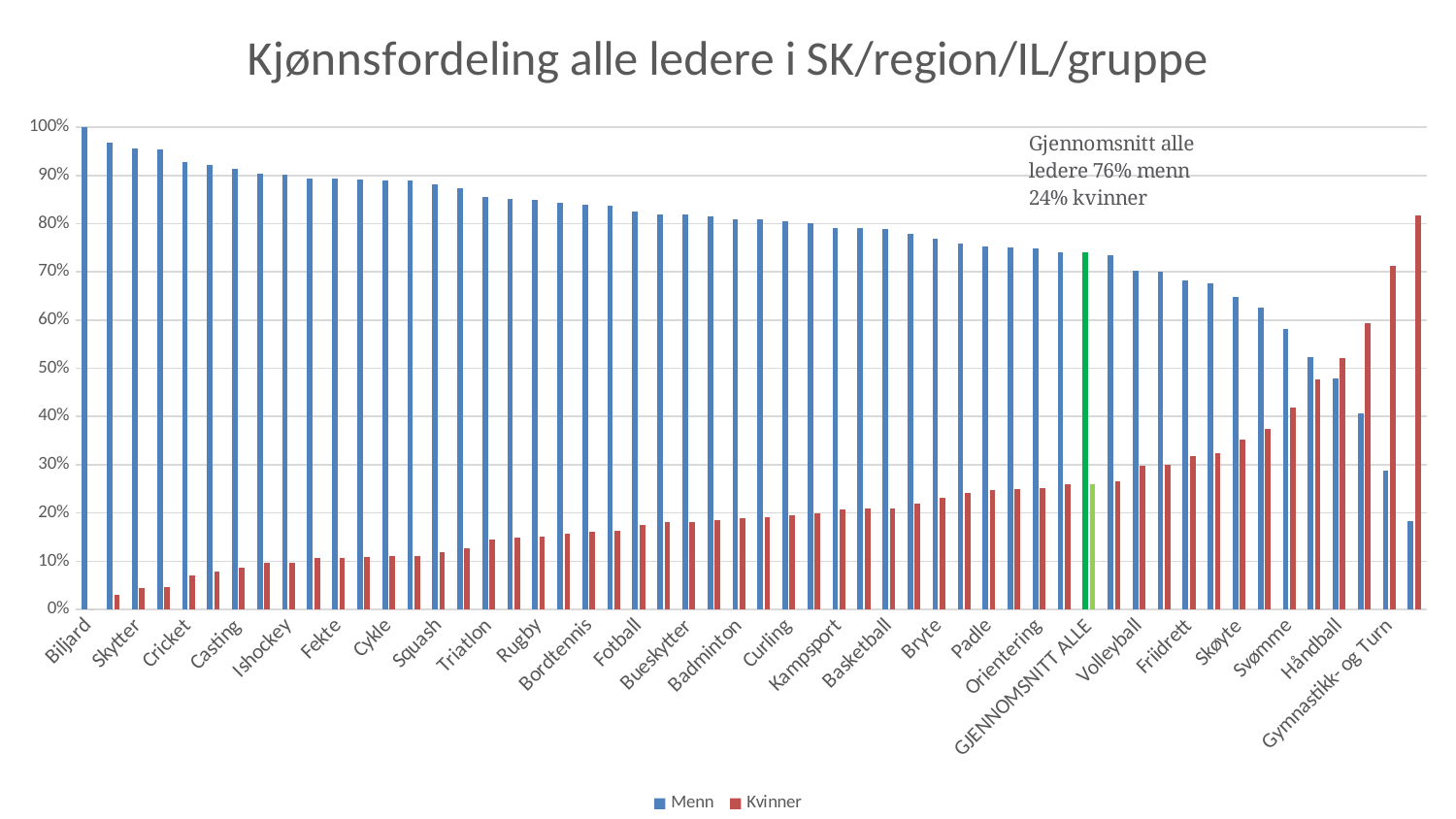
Which category has the highest Menn value? Biljard According to the text on the chart, what is the average share of Kvinner among all leaders? 24% Do the Menn values generally rise or fall from left to right along the x axis? Fall For Gymnastikk- og Turn, which is larger: the Menn value or the Kvinner value? Kvinner What is the Menn value for Biljard? 100% Is the Menn value for Skytter greater or less than 90%? greater According to the text on the chart, what is the average share of Menn among all leaders? 76% How many series does the legend list? 2 Is the Menn value for Skøyte greater or less than 70%? less Which labelled category has the highest Kvinner value? Gymnastikk- og Turn What type of chart is shown on the slide? Bar chart Is the Kvinner value for Skytter greater or less than 10%? less